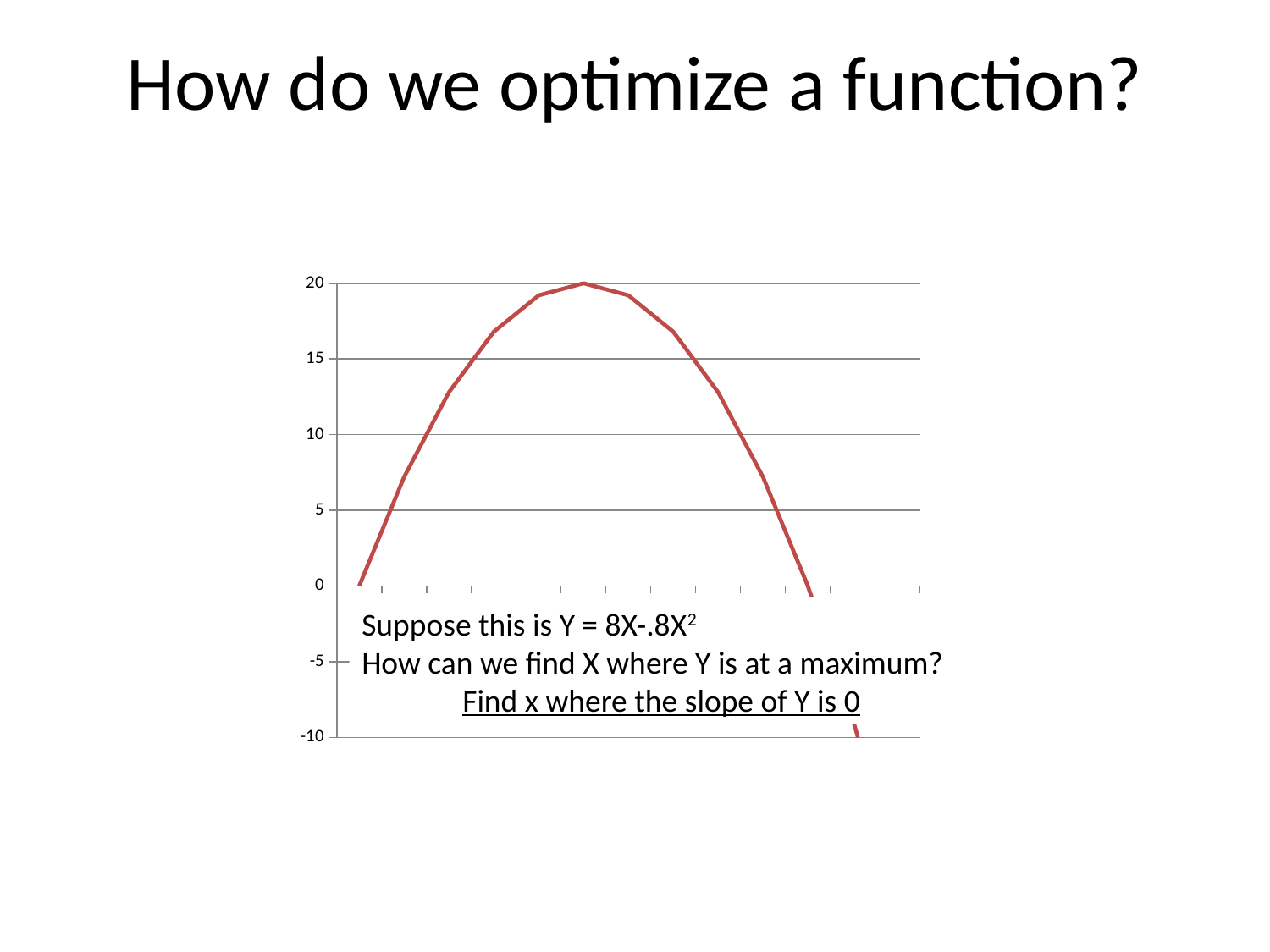
Is the value of the plotted line at its rightmost visible point greater or less than -5? less Does the plotted line rise or fall as it moves from the middle of the chart toward the right edge? fall Is the peak value of the plotted line greater or less than 15? greater What colour is the plotted line? red What kind of chart is shown on the slide? line chart Does the plotted line rise or fall as it moves from the left edge toward the middle of the chart? rise What is the value of the plotted line at its leftmost point? 0 What is the lowest value labelled on the vertical axis? -10 What is the highest value reached by the plotted line? 20